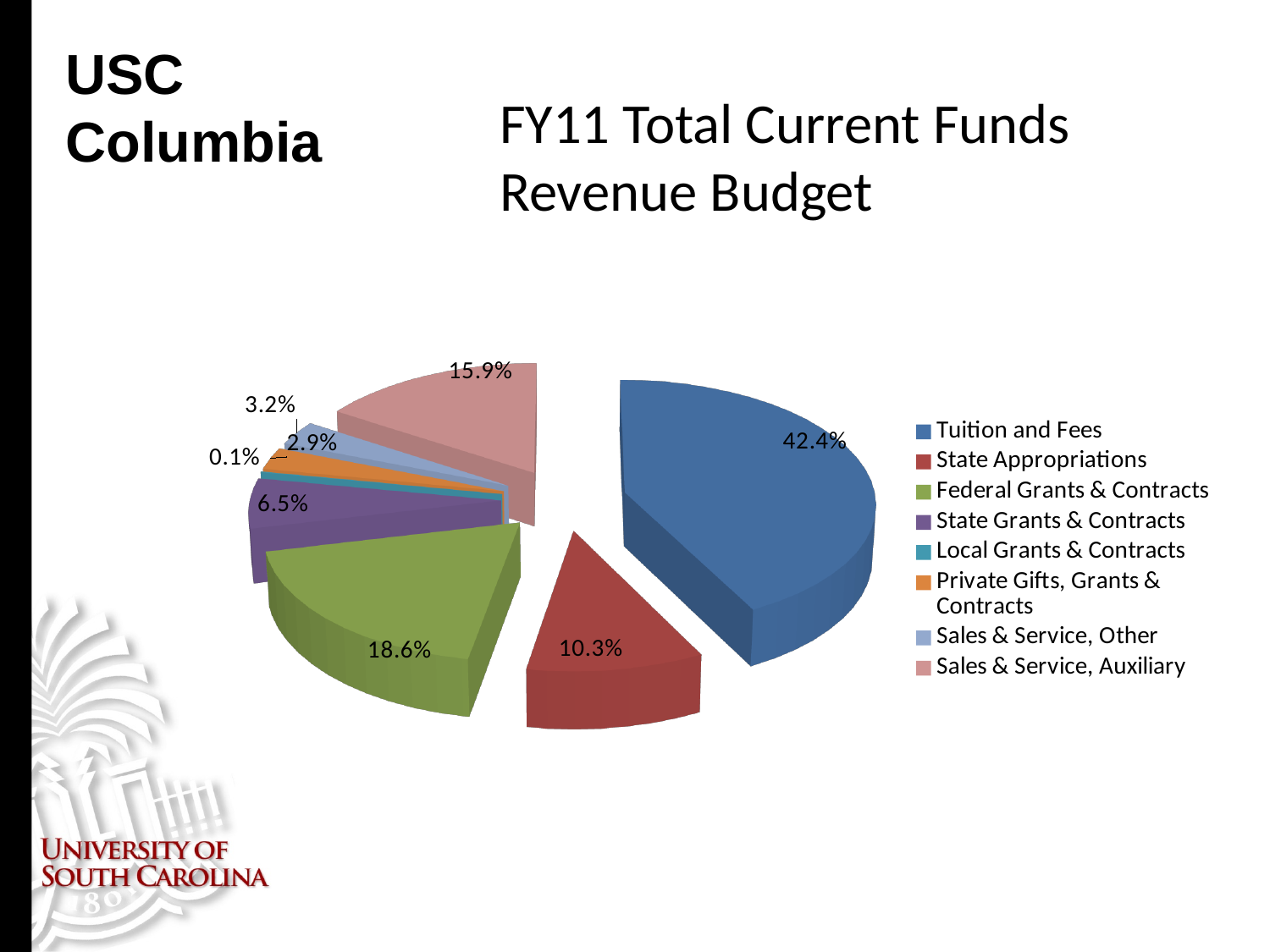
What is the title of the chart? FY11 Total Current Funds Revenue Budget What kind of chart is shown on the slide? Pie chart Which category has the largest share of the revenue budget? Tuition and Fees What percentage of the revenue budget is Federal Grants & Contracts? 18.6% What percentage of the revenue budget is Sales & Service, Auxiliary? 15.9% Which category has the smallest share of the revenue budget? Local Grants & Contracts What is the difference in percentage points between Federal Grants & Contracts and State Appropriations? 8.3 How many categories does the legend list? 8 What percentage of the revenue budget is State Appropriations? 10.3% What share of the FY11 Total Current Funds Revenue Budget comes from Tuition and Fees? 42.4% What percentage of the revenue budget is State Grants & Contracts? 6.5% Which is larger: the share for Sales & Service, Auxiliary or the share for State Appropriations? Sales & Service, Auxiliary